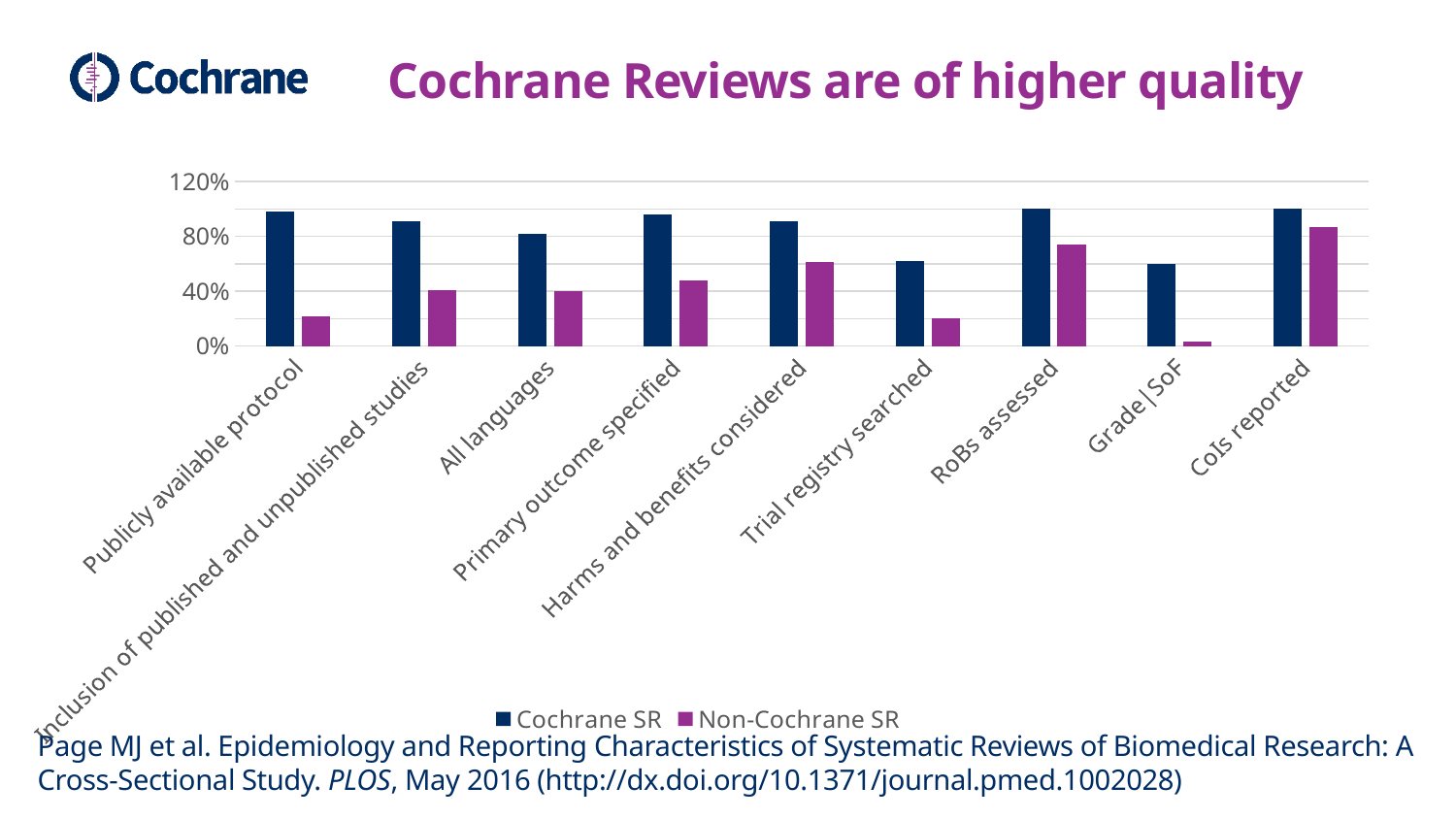
Is the Non-Cochrane SR value for CoIs reported greater or less than 80%? greater Is the Cochrane SR value for Trial registry searched greater or less than 80%? less Is the Non-Cochrane SR value for Harms and benefits considered greater or less than 40%? greater For Publicly available protocol, which series has the larger value, Cochrane SR or Non-Cochrane SR? Cochrane SR Which category has the lowest Non-Cochrane SR value? Grade|SoF How many categories are shown on the x axis? 9 What is the title of the chart on the slide? Cochrane Reviews are of higher quality Which category has the highest Non-Cochrane SR value? CoIs reported How many series does the legend list? 2 What kind of chart is shown on the slide? bar chart